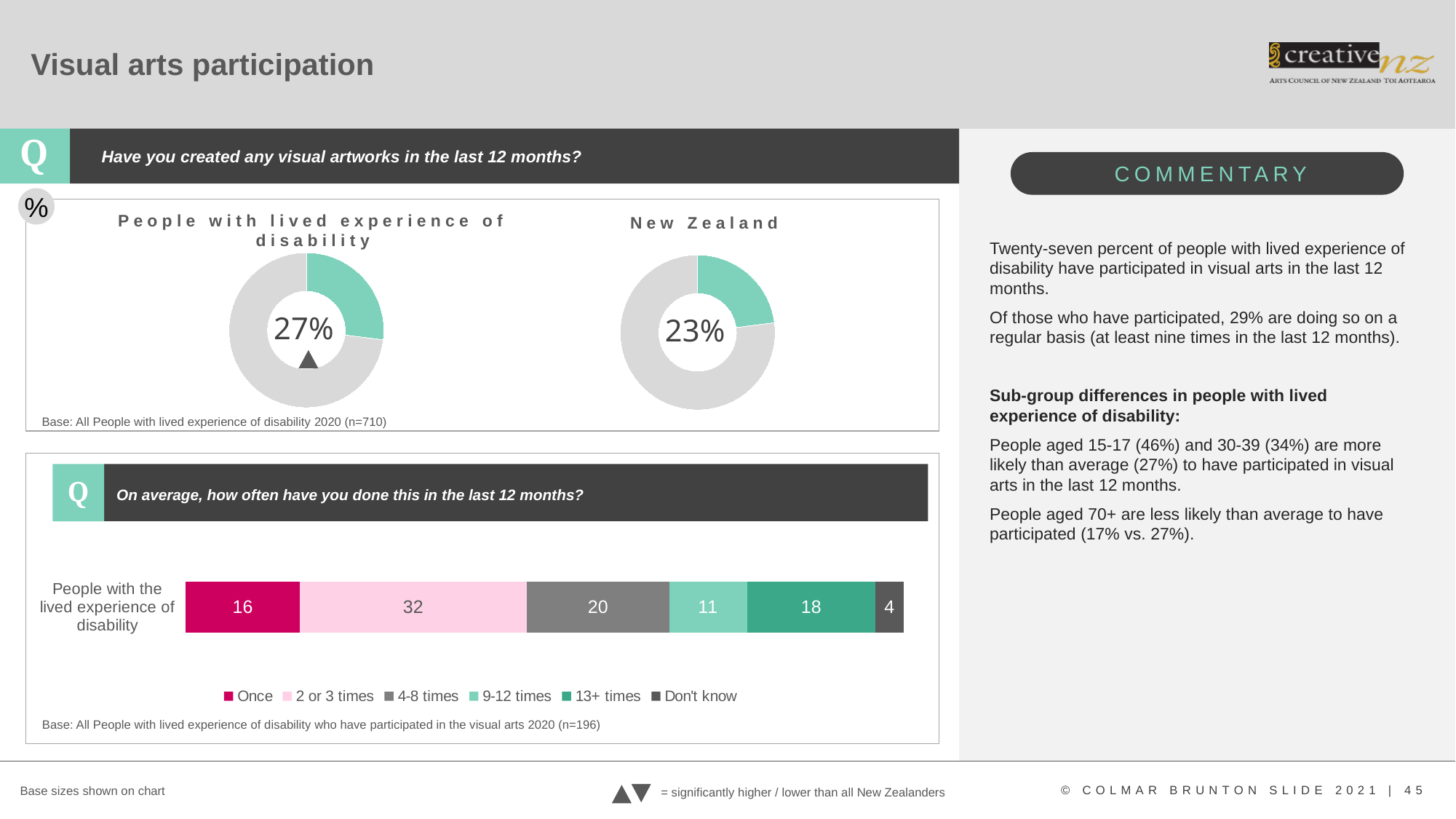
In the stacked bar chart about how often people have done this in the last 12 months, what is the value for 'Once'? 16 In the stacked bar chart about how often people have done this in the last 12 months, which frequency category has the largest value? 2 or 3 times In the 'New Zealand' donut chart, what percentage is shown in the centre? 23% How many series does the legend of the stacked bar chart list? 6 What type of chart is used to show how often people have done this in the last 12 months? Stacked bar chart In the stacked bar chart about how often people have done this in the last 12 months, what is the value for '2 or 3 times'? 32 In the stacked bar chart about how often people have done this in the last 12 months, which category has the smallest value? Don't know In the 'People with lived experience of disability' donut chart, what percentage is shown in the centre? 27% In the stacked bar chart about how often people have done this in the last 12 months, what is the value for '13+ times'? 18 In the stacked bar chart about how often people have done this in the last 12 months, what is the difference between the '4-8 times' value and the '9-12 times' value? 9 What is the difference between the percentage in the 'People with lived experience of disability' donut and the 'New Zealand' donut? 4 percentage points Comparing the two donut charts, which group has the higher visual arts participation percentage: people with lived experience of disability or New Zealand? People with lived experience of disability